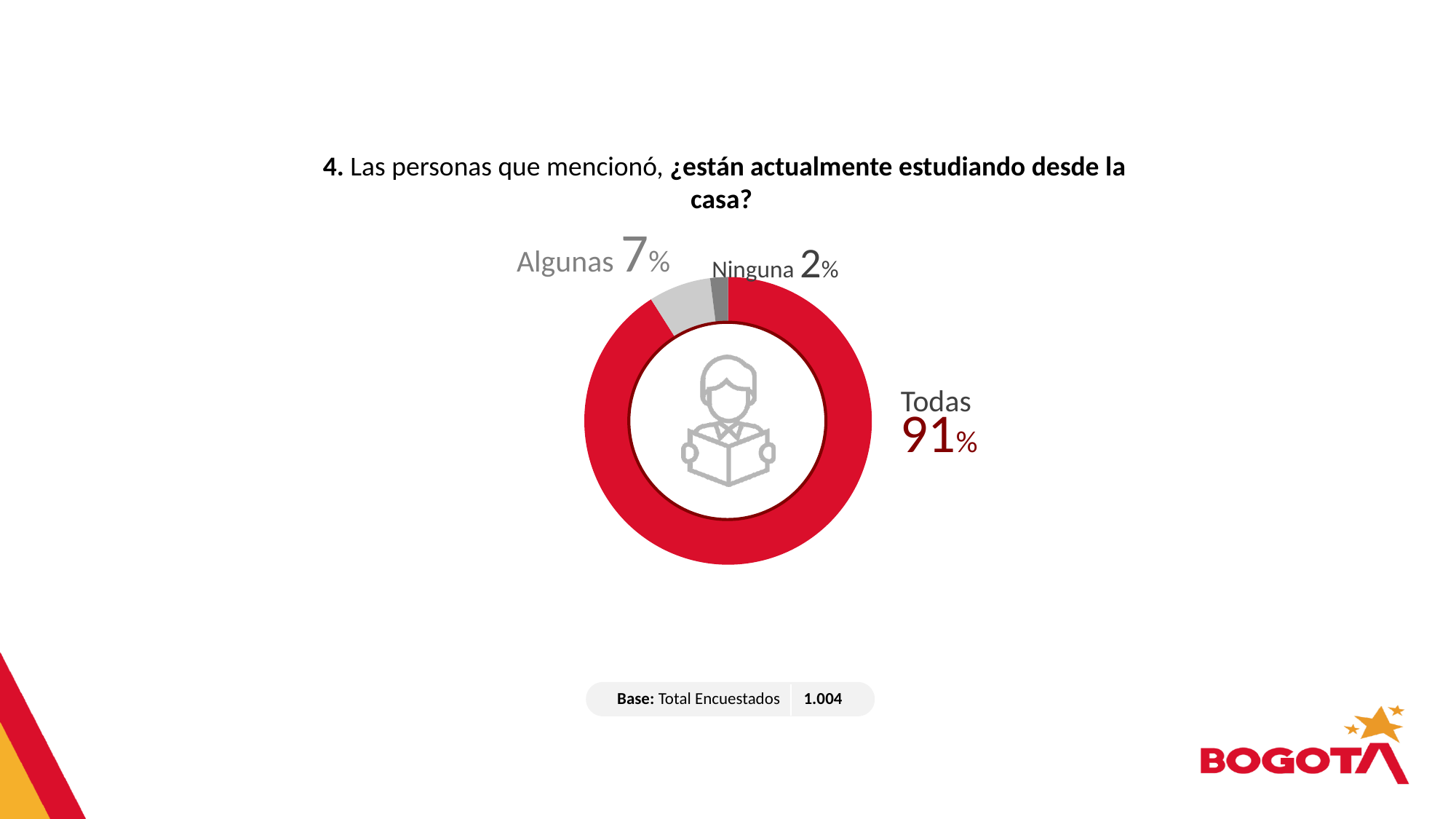
Which category has the smallest share of the chart? Ninguna What percentage is shown for "Todas"? 91% How many categories are shown in the chart? 3 What is the difference in percentage points between "Todas" and "Algunas"? 84 What is the base (total respondents) shown below the chart? 1.004 What percentage is shown for "Ninguna"? 2% Which category has the largest share of the chart? Todas What colour is the segment for "Todas"? Red Which is larger, the share for "Algunas" or the share for "Ninguna"? Algunas What kind of chart is shown on the slide? Doughnut (pie) chart What is the difference in percentage points between "Algunas" and "Ninguna"? 5 What percentage is shown for "Algunas"? 7%